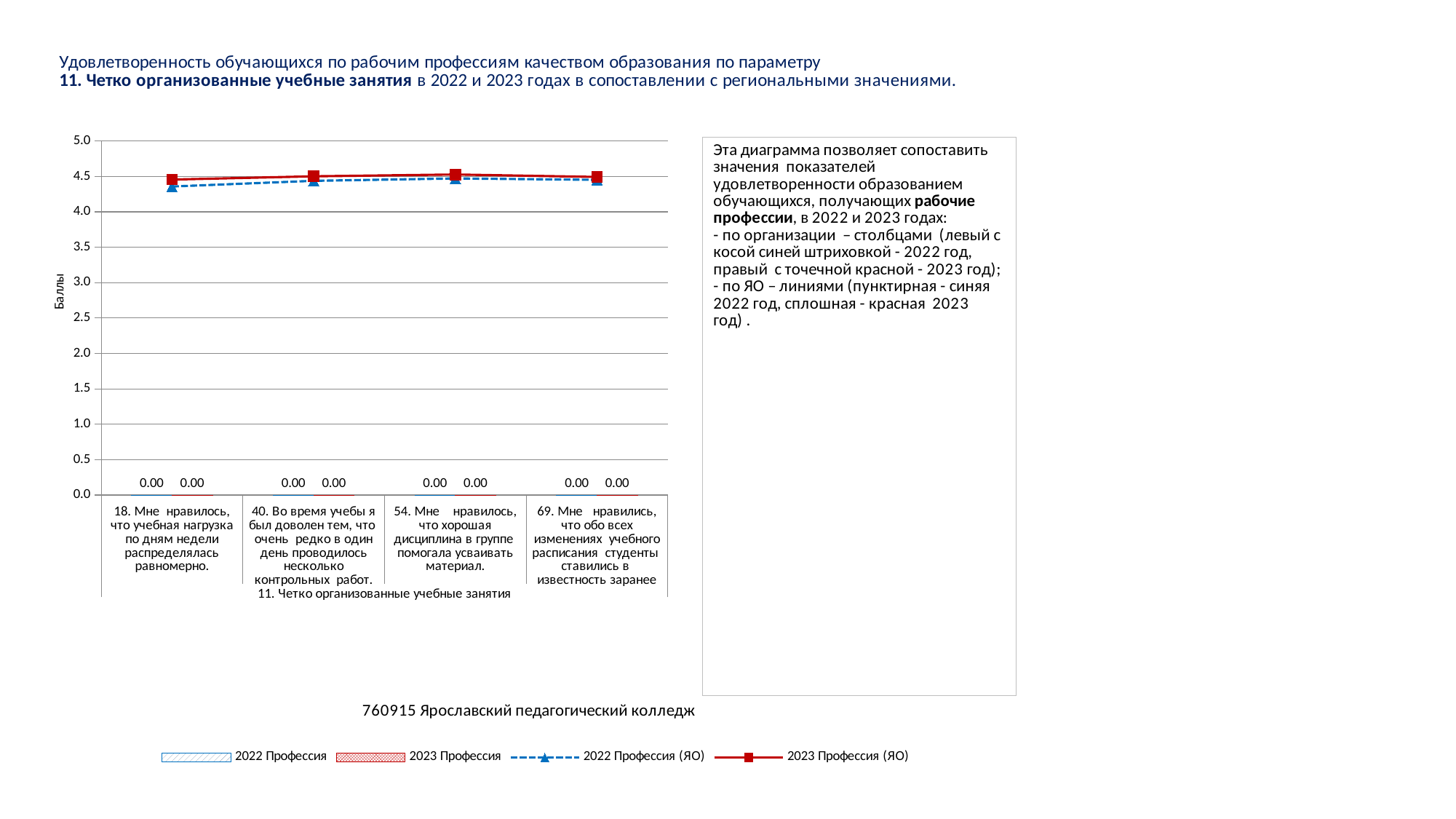
How many categories are shown on the x axis of the chart? 4 What is the sum of the 2022 Профессия and 2023 Профессия bar values for category "54. Мне нравилось, что хорошая дисциплина в группе помогала усваивать материал."? 0.00 How many series does the chart legend list? 4 What is the value of the 2022 Профессия bar for category "18. Мне нравилось, что учебная нагрузка по дням недели распределялась равномерно."? 0.00 Is the value of the 2023 Профессия (ЯО) line for category "54. Мне нравилось, что хорошая дисциплина в группе помогала усваивать материал." greater or less than 4.0? greater Is the value of the 2023 Профессия (ЯО) line for category "40. Во время учебы я был доволен тем, что очень редко в один день проводилось несколько контрольных работ." greater or less than 4.0? greater What kind of chart is shown on the slide? Combined bar and line chart What is the label of the vertical axis of the chart? Баллы Is the value of the 2022 Профессия (ЯО) line for category "18. Мне нравилось, что учебная нагрузка по дням недели распределялась равномерно." greater or less than 4.5? less For category "18. Мне нравилось, что учебная нагрузка по дням недели распределялась равномерно.", which line is higher: 2022 Профессия (ЯО) or 2023 Профессия (ЯО)? 2023 Профессия (ЯО) What is the value of the 2023 Профессия bar for category "69. Мне нравились, что обо всех изменениях учебного расписания студенты ставились в известность заранее"? 0.00 What organisation name is printed below the chart? 760915 Ярославский педагогический колледж